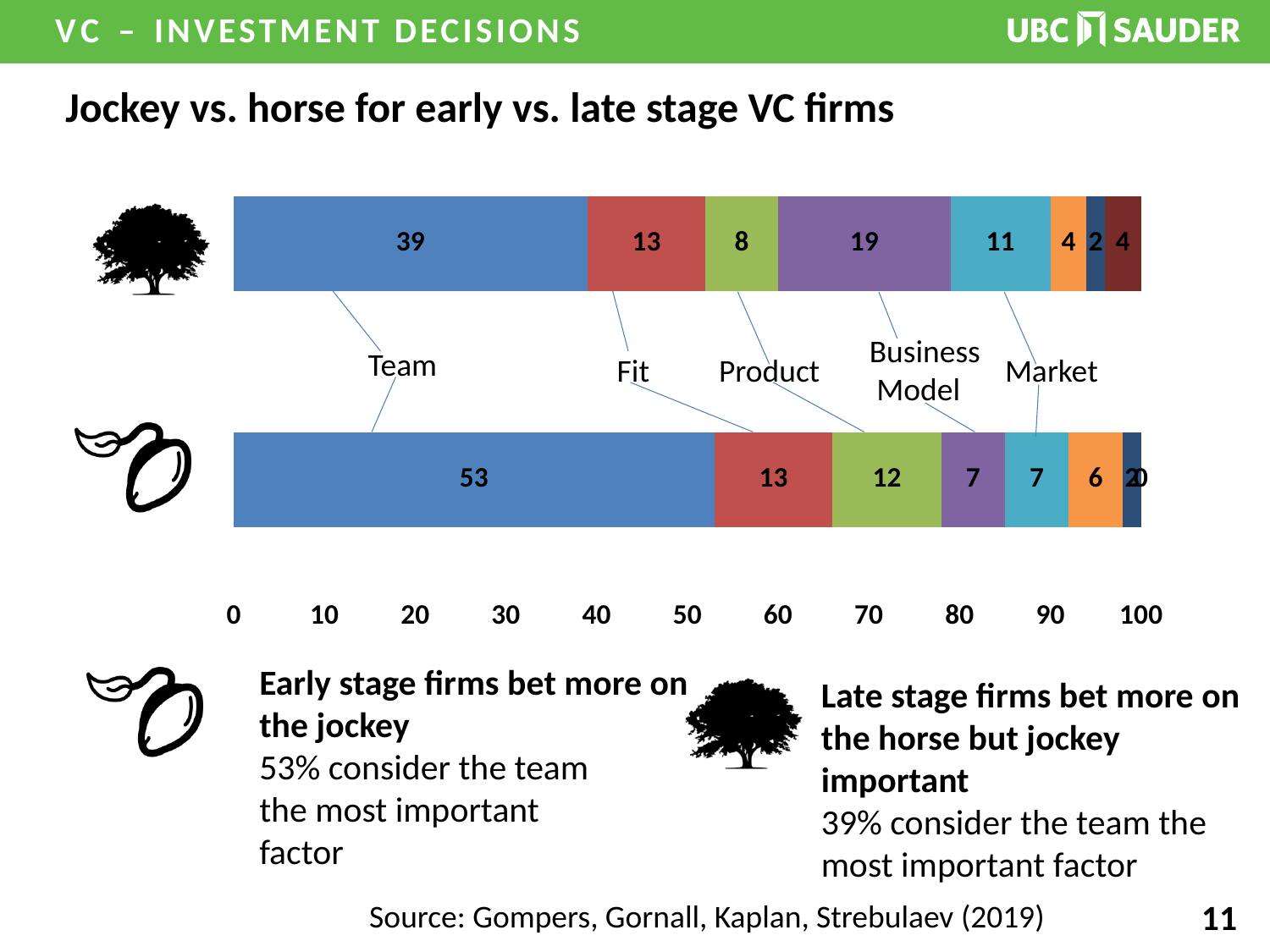
What value is shown for Team in the bottom bar (early stage firms, seed icon)? 53 What is the difference between the Business Model values for late stage (19) and early stage (7) firms? 12 What value is shown for Team in the top bar (late stage firms, tree icon)? 39 How many bars does the chart contain? 2 What value is shown for Product in the bottom bar (early stage firms)? 12 What value is shown for Market in the top bar (late stage firms)? 11 What is the difference between the Team values for early stage (53) and late stage (39) firms? 14 Which labelled category has the largest segment in the top bar (late stage firms)? Team Which labelled category has the smallest segment in the top bar (late stage firms)? Product What kind of chart is shown on the slide? Stacked bar chart Is the Business Model value larger for late stage firms or early stage firms? Late stage firms What value is shown for Business Model in the top bar (late stage firms)? 19